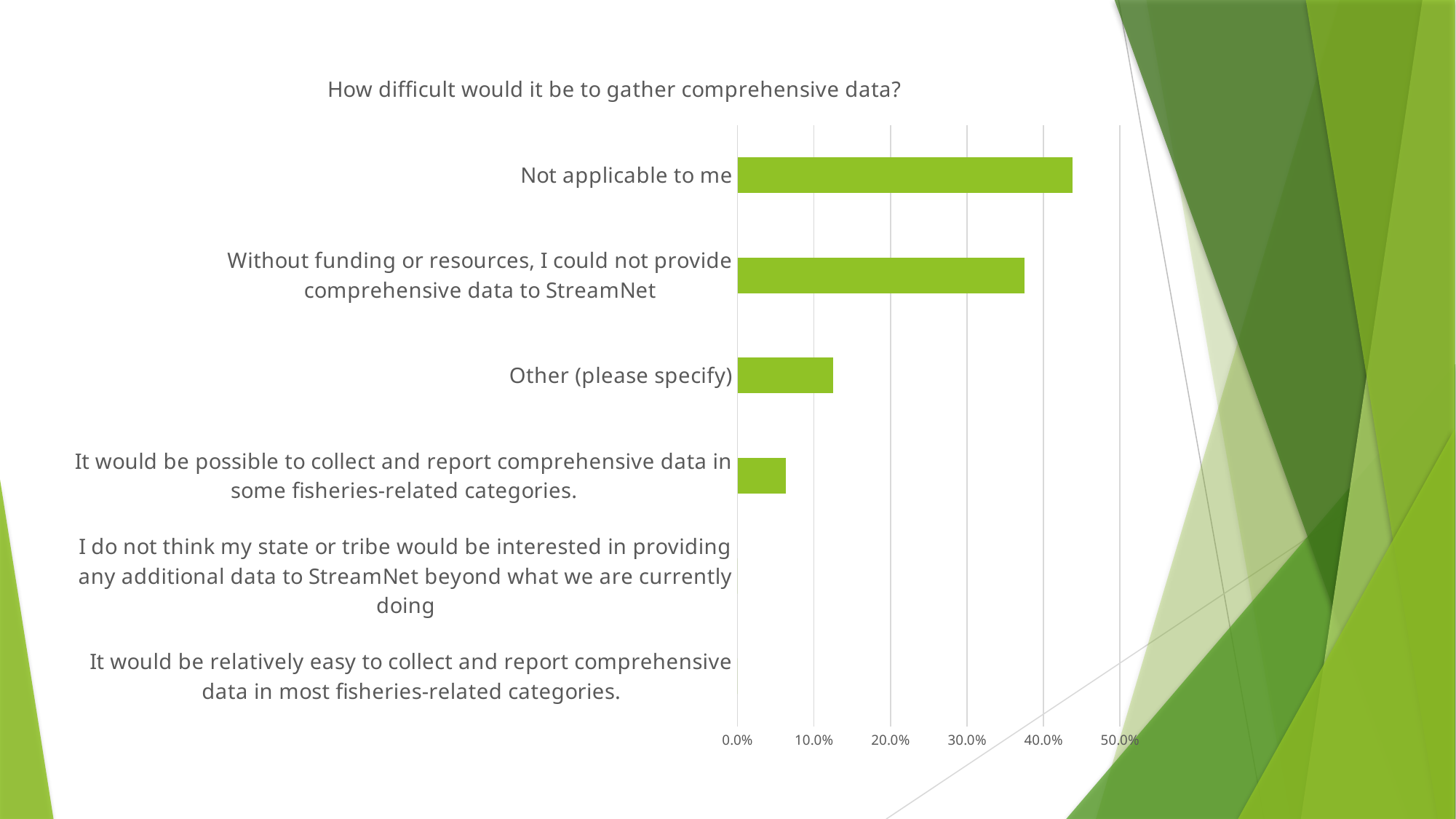
Is the value for "It would be possible to collect and report comprehensive data in some fisheries-related categories." greater or less than 10.0%? less Which is larger: the value for "Not applicable to me" or the value for "Without funding or resources, I could not provide comprehensive data to StreamNet"? Not applicable to me Is the value for "Not applicable to me" greater or less than 40.0%? greater What is the title of the chart? How difficult would it be to gather comprehensive data? How many categories are listed on the chart's vertical axis? 6 Is the value for "Without funding or resources, I could not provide comprehensive data to StreamNet" greater or less than 30.0%? greater Which category has the highest value? Not applicable to me What kind of chart is shown on the slide? bar chart What is the highest tick label shown on the horizontal axis? 50.0% Which is larger: the value for "Other (please specify)" or the value for "It would be possible to collect and report comprehensive data in some fisheries-related categories."? Other (please specify)